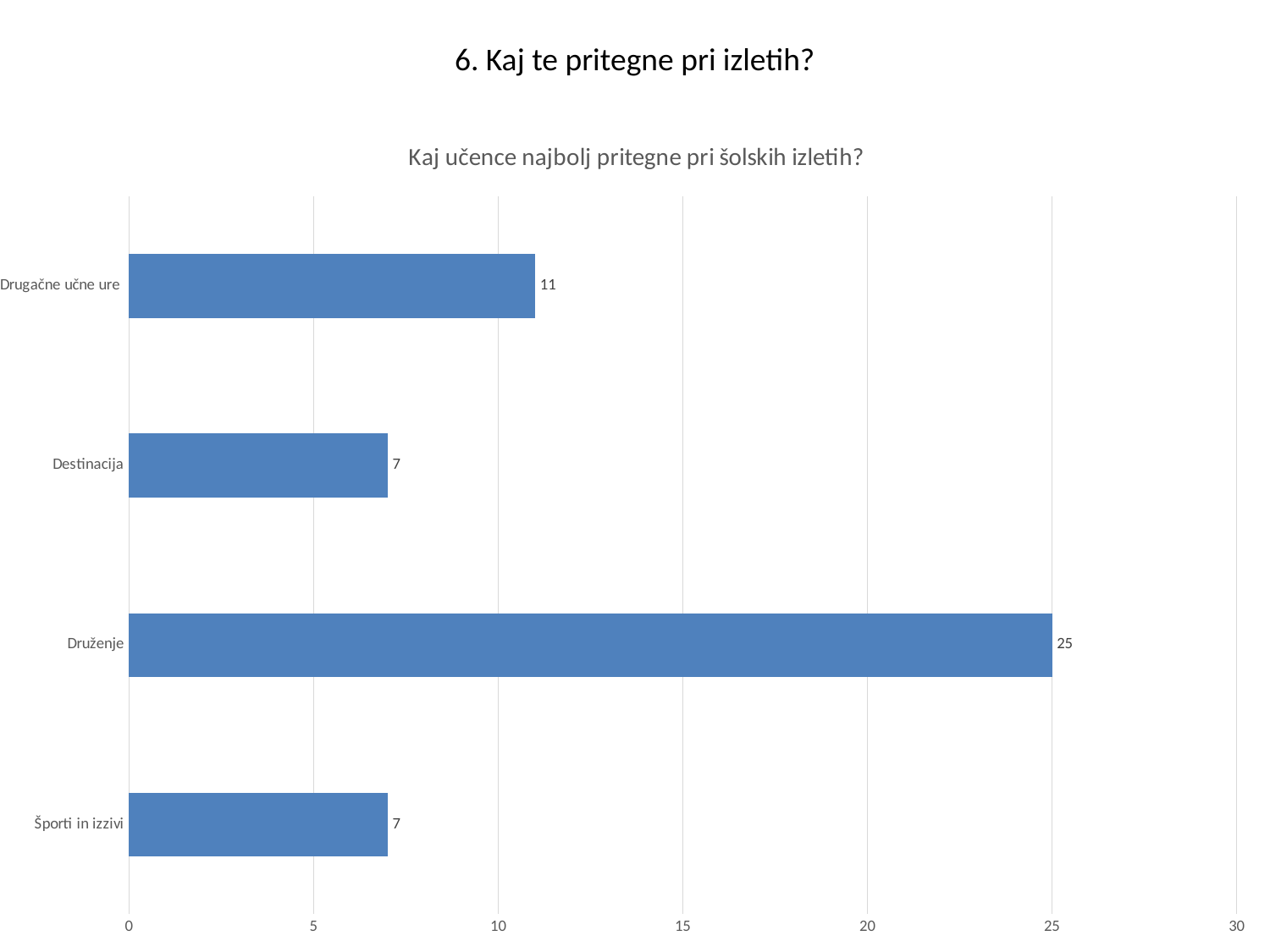
Which is larger, the value for Druženje or the value for Destinacija? Druženje What is the value for Destinacija? 7 What kind of chart is shown on the slide? Bar chart What is the title of the chart? Kaj učence najbolj pritegne pri šolskih izletih? What is the value for Druženje? 25 What is the difference between the values for Druženje and Drugačne učne ure? 14 What is the value for Drugačne učne ure? 11 How many categories are shown in the chart? 4 Which category has the highest value? Druženje What is the difference between the values for Drugačne učne ure and Destinacija? 4 Is the value for Druženje greater or less than 20? greater What is the value for Športi in izzivi? 7